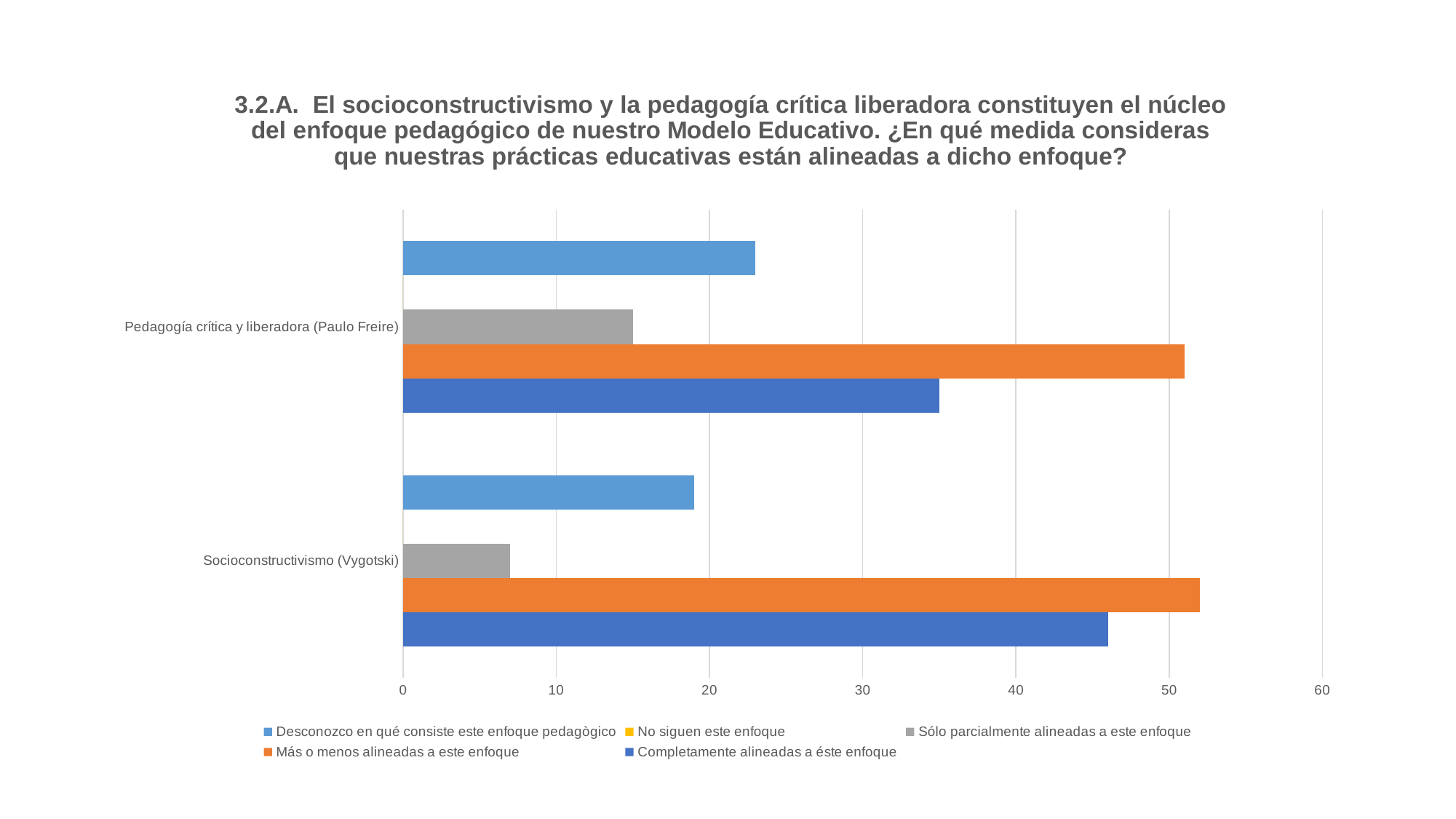
What kind of chart is shown on the slide? bar chart Is the value for 'Sólo parcialmente alineadas a este enfoque' in the Socioconstructivismo (Vygotski) category greater or less than 10? less Is the value for 'Desconozco en qué consiste este enfoque pedagògico' in the Pedagogía crítica y liberadora (Paulo Freire) category greater or less than 30? less Is the value for 'Completamente alineadas a éste enfoque' in the Pedagogía crítica y liberadora (Paulo Freire) category greater or less than 30? greater Which series has the highest value in the Socioconstructivismo (Vygotski) category? Más o menos alineadas a este enfoque For 'Completamente alineadas a éste enfoque', which category has the larger value: Socioconstructivismo (Vygotski) or Pedagogía crítica y liberadora (Paulo Freire)? Socioconstructivismo (Vygotski) How many series does the legend list? 5 How many categories are shown on the vertical axis? 2 What colour are the bars for 'Más o menos alineadas a este enfoque'? orange Which series has the lowest visible bar in the Pedagogía crítica y liberadora (Paulo Freire) category? Sólo parcialmente alineadas a este enfoque For 'Sólo parcialmente alineadas a este enfoque', which category has the larger value: Socioconstructivismo (Vygotski) or Pedagogía crítica y liberadora (Paulo Freire)? Pedagogía crítica y liberadora (Paulo Freire)